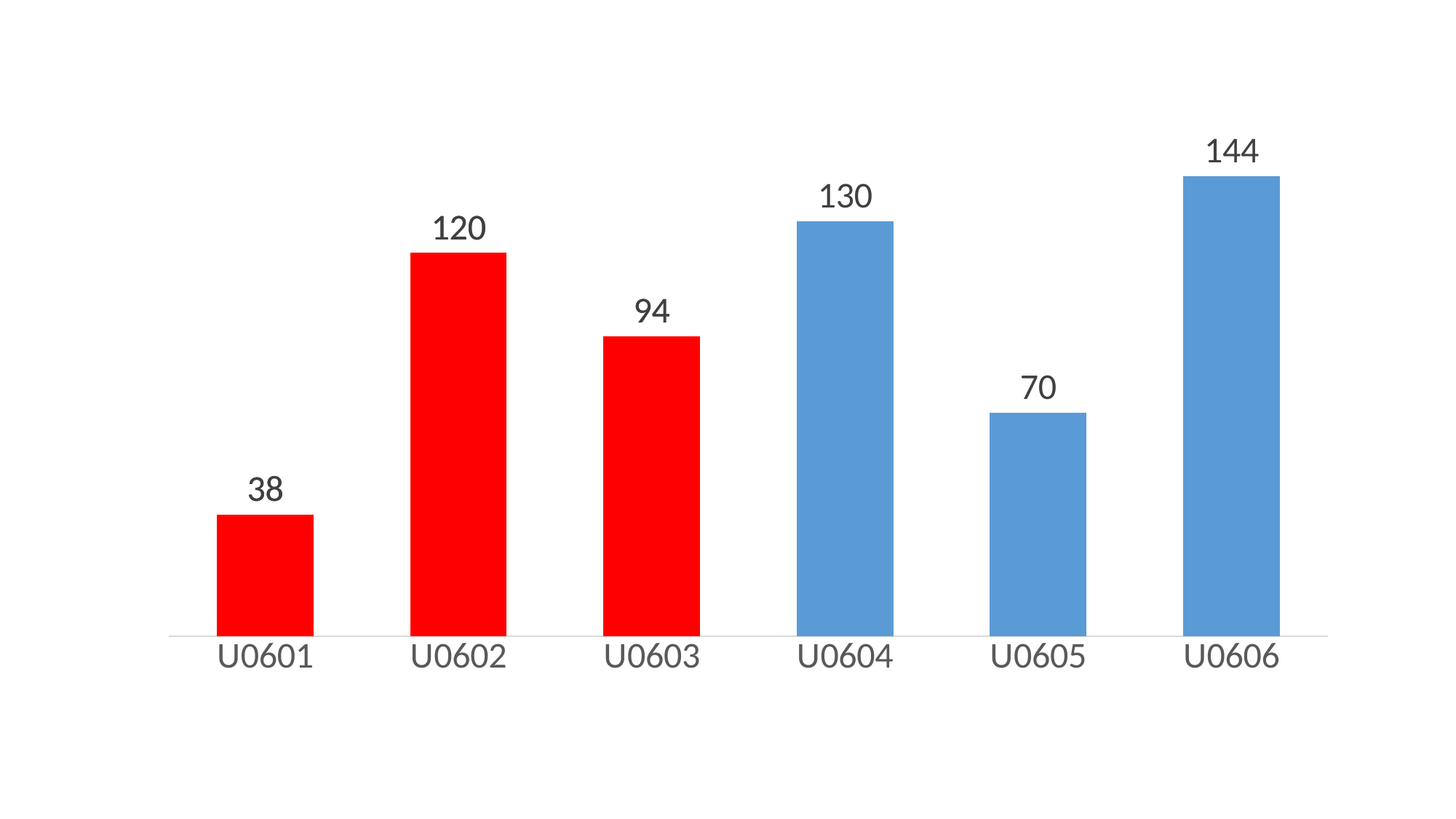
Which is larger, the value for U0603 or the value for U0605? U0603 What is the difference between the values for U0603 and U0601? 56 What is the difference between the values for U0606 and U0602? 24 What is the value for U0601? 38 How many categories are shown on the chart? 6 Which is larger, the value for U0602 or the value for U0604? U0604 What kind of chart is shown on the slide? Bar chart What is the value for U0605? 70 What is the value for U0604? 130 Which category has the lowest value? U0601 Which category has the highest value? U0606 What colour are the bars for U0604, U0605 and U0606? Blue